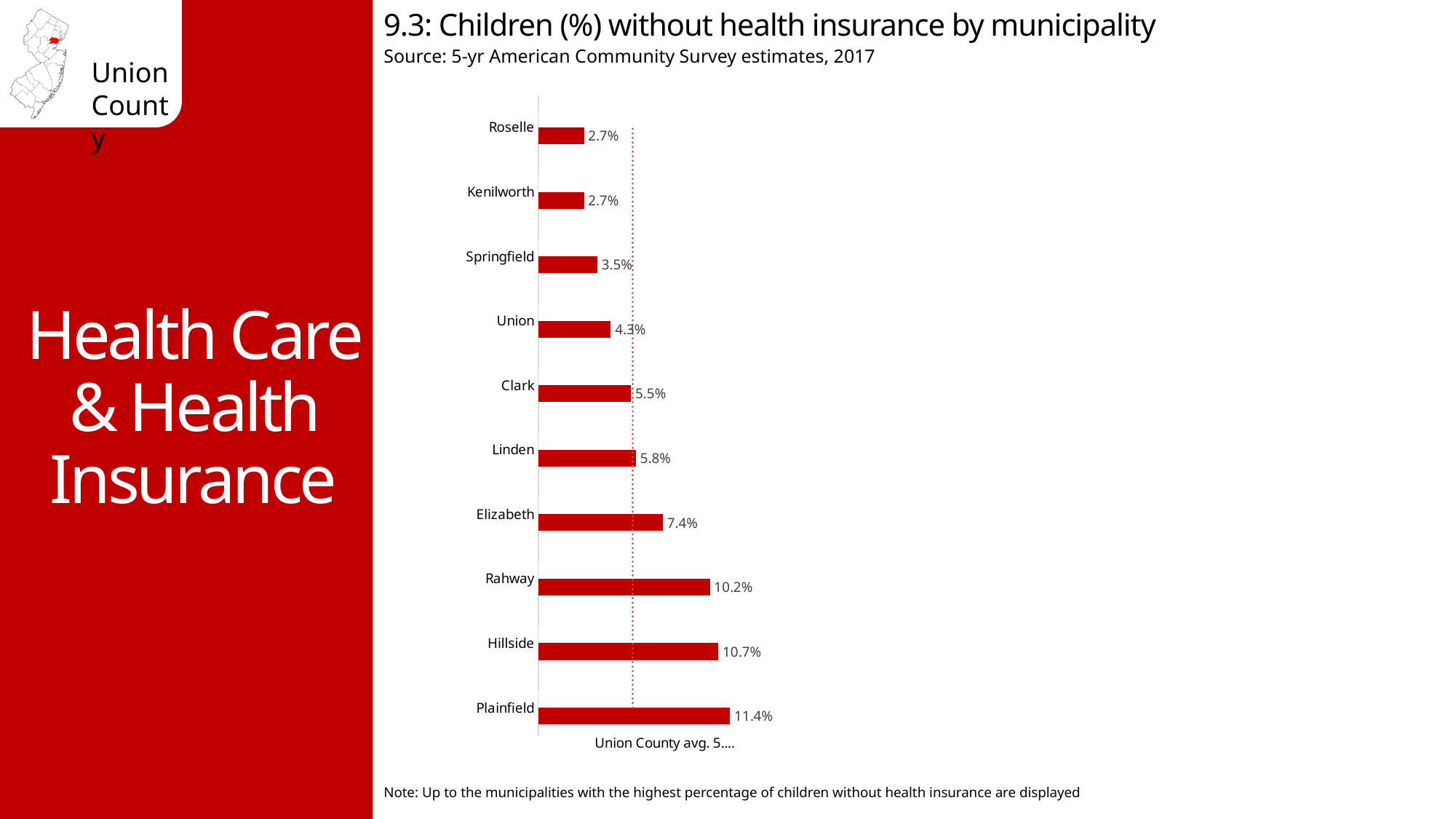
Which has a higher value, Linden or Clark? Linden What is the value shown for Union? 4.3% What kind of chart is shown on the slide? Bar chart Which has a higher value, Hillside or Rahway? Hillside Which municipality has the highest percentage of children without health insurance? Plainfield What is the value shown for Elizabeth? 7.4% What is the difference between the values for Rahway and Elizabeth? 2.8% Which municipality has the lowest value on the chart? Roselle and Kenilworth (both 2.7%) What percentage of children in Plainfield are without health insurance? 11.4% What is the difference between the values for Plainfield and Hillside? 0.7% How many municipalities are shown on the chart? 10 What is the source of the data shown in the chart? 5-yr American Community Survey estimates, 2017